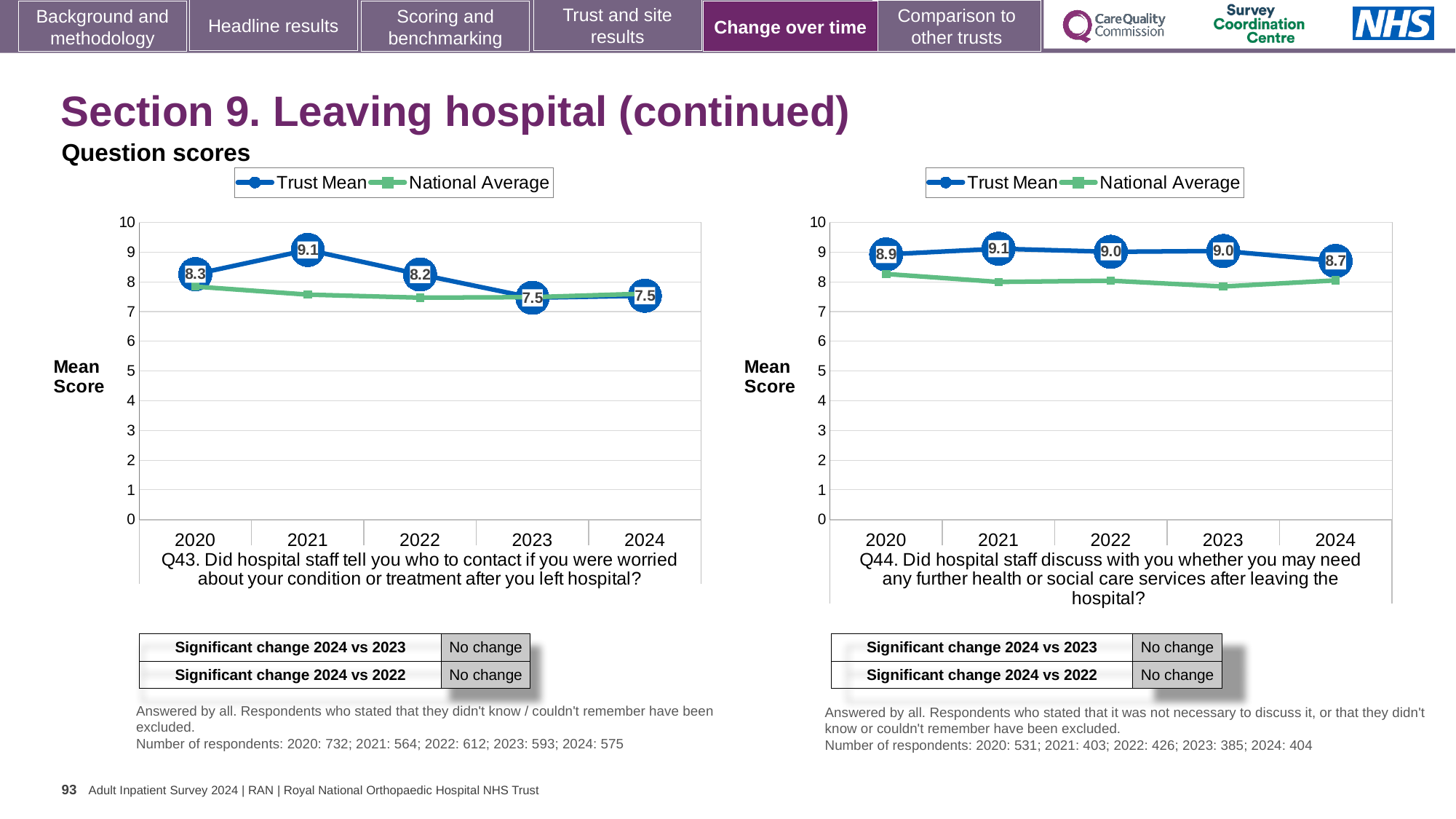
In the Q43 chart (left), what is the difference between the Trust Mean scores for 2021 and 2023? 1.6 In the Q43 chart (left), what is the Trust Mean score for 2021? 9.1 In the Q44 chart (right), is the National Average for 2023 greater or less than 8? less In the Q44 chart (right), what is the Trust Mean score for 2024? 8.7 In the Q44 chart (right), which is larger, the Trust Mean score for 2021 or for 2024? 2021 In the Q43 chart (left), what is the Trust Mean score for 2024? 7.5 In the Q44 chart (right), what is the Trust Mean score for 2020? 8.9 In the Q43 chart (left), which year has the highest Trust Mean score? 2021 How many series does the legend of the Q44 chart (right) list? 2 What kind of chart is the Q43 chart (left)? Line chart How many years are shown on the x axis of the Q43 chart (left)? 5 In the Q44 chart (right), which year has the lowest Trust Mean score? 2024